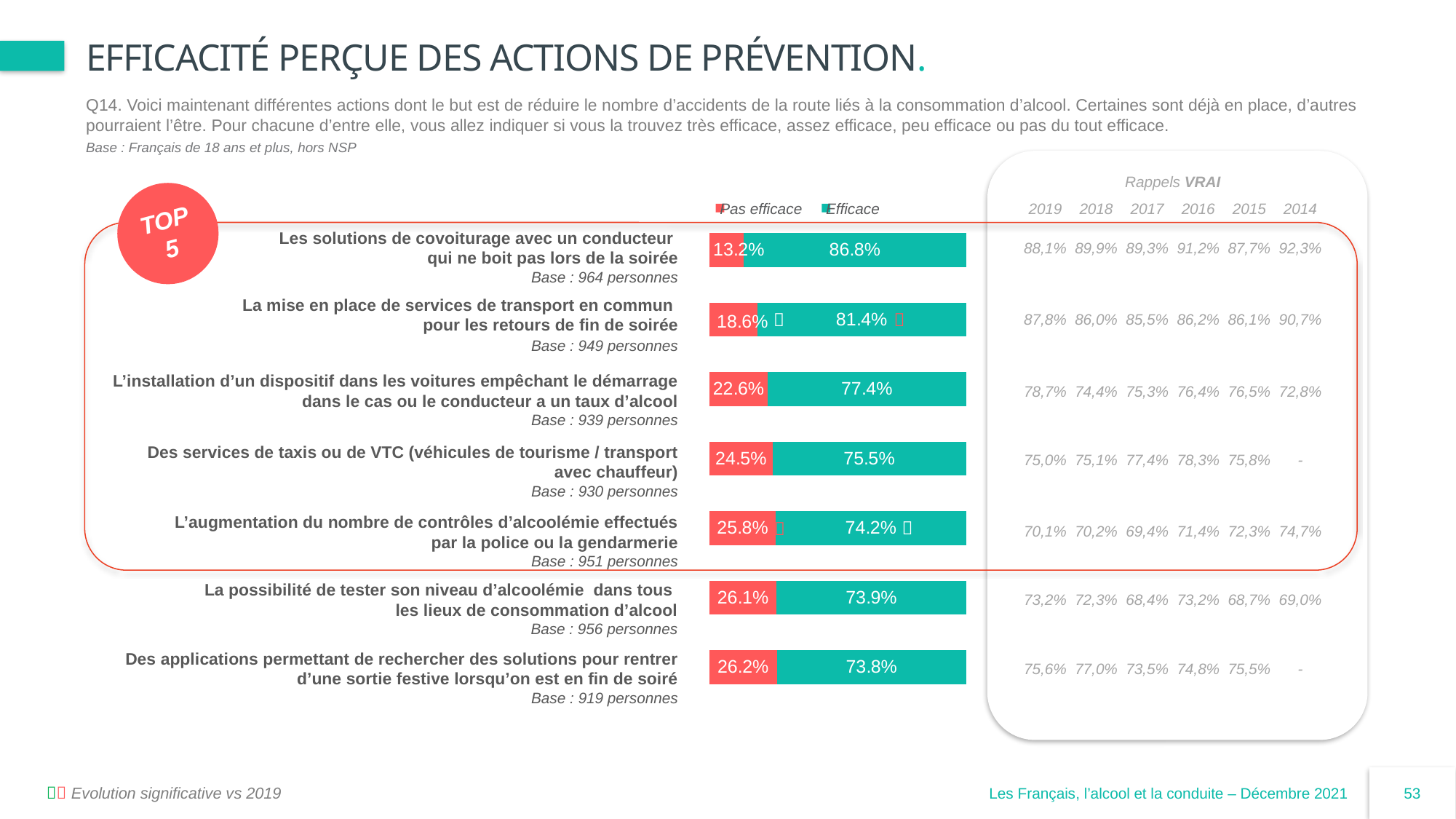
How many actions (categories) are shown in the bar chart? 7 What is the total of the "Pas efficace" and "Efficace" values for "La possibilité de tester son niveau d'alcoolémie dans tous les lieux de consommation d'alcool"? 100% How many series does the legend list? 2 What is the "Pas efficace" value for "Des services de taxis ou de VTC"? 24.5% What is the difference between the "Efficace" values for carpooling solutions (86.8%) and public transport services (81.4%)? 5.4 percentage points What is the "Efficace" value for "L'augmentation du nombre de contrôles d'alcoolémie effectués par la police ou la gendarmerie"? 74.2% What percentage of respondents find carpooling solutions with a non-drinking driver ("Les solutions de covoiturage avec un conducteur qui ne boit pas lors de la soirée") effective ("Efficace")? 86.8% What kind of chart is used to show the perceived effectiveness of the actions? Stacked bar chart Which has a higher "Pas efficace" value: "La mise en place de services de transport en commun" or "L'installation d'un dispositif dans les voitures empêchant le démarrage"? L'installation d'un dispositif dans les voitures empêchant le démarrage Which action has the lowest "Efficace" percentage? Des applications permettant de rechercher des solutions pour rentrer d'une sortie festive lorsqu'on est en fin de soiré Which action has the highest "Efficace" percentage? Les solutions de covoiturage avec un conducteur qui ne boit pas lors de la soirée Which colour represents the "Efficace" series in the chart? Teal (green)